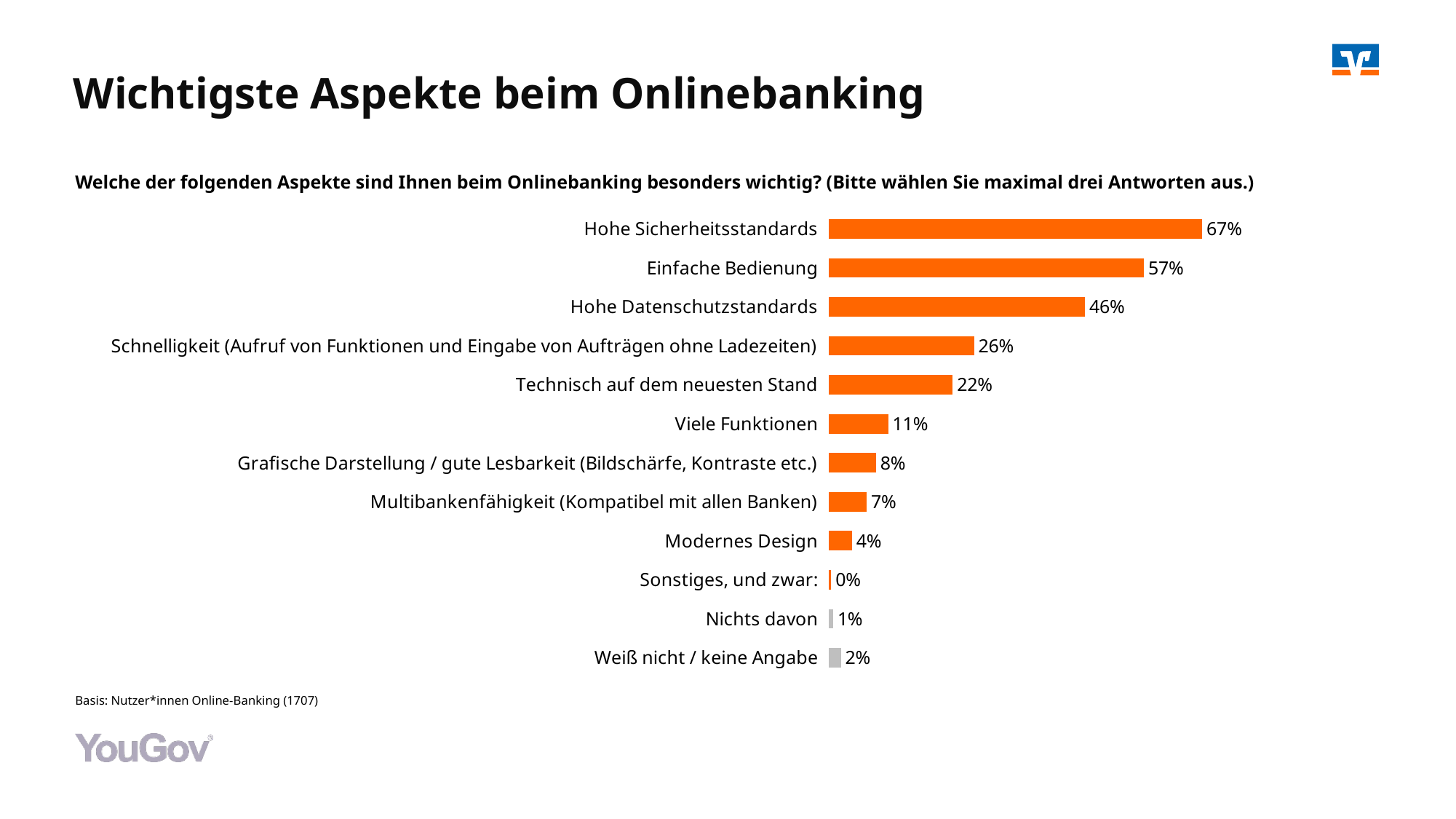
What is the difference between Schnelligkeit (Aufruf von Funktionen und Eingabe von Aufträgen ohne Ladezeiten) and Viele Funktionen? 15% What is the title of the slide? Wichtigste Aspekte beim Onlinebanking Which category has the highest value? Hohe Sicherheitsstandards What kind of chart is shown on the slide? Bar chart What is the value for Technisch auf dem neuesten Stand? 22% How many categories are shown in the chart? 12 What is the value for Hohe Sicherheitsstandards? 67% Which category has the lowest value? Sonstiges, und zwar: What is the value for Einfache Bedienung? 57% Which is larger, Grafische Darstellung / gute Lesbarkeit (Bildschärfe, Kontraste etc.) or Multibankenfähigkeit (Kompatibel mit allen Banken)? Grafische Darstellung / gute Lesbarkeit (Bildschärfe, Kontraste etc.) What is the value for Modernes Design? 4% What is the difference between Hohe Sicherheitsstandards and Hohe Datenschutzstandards? 21%